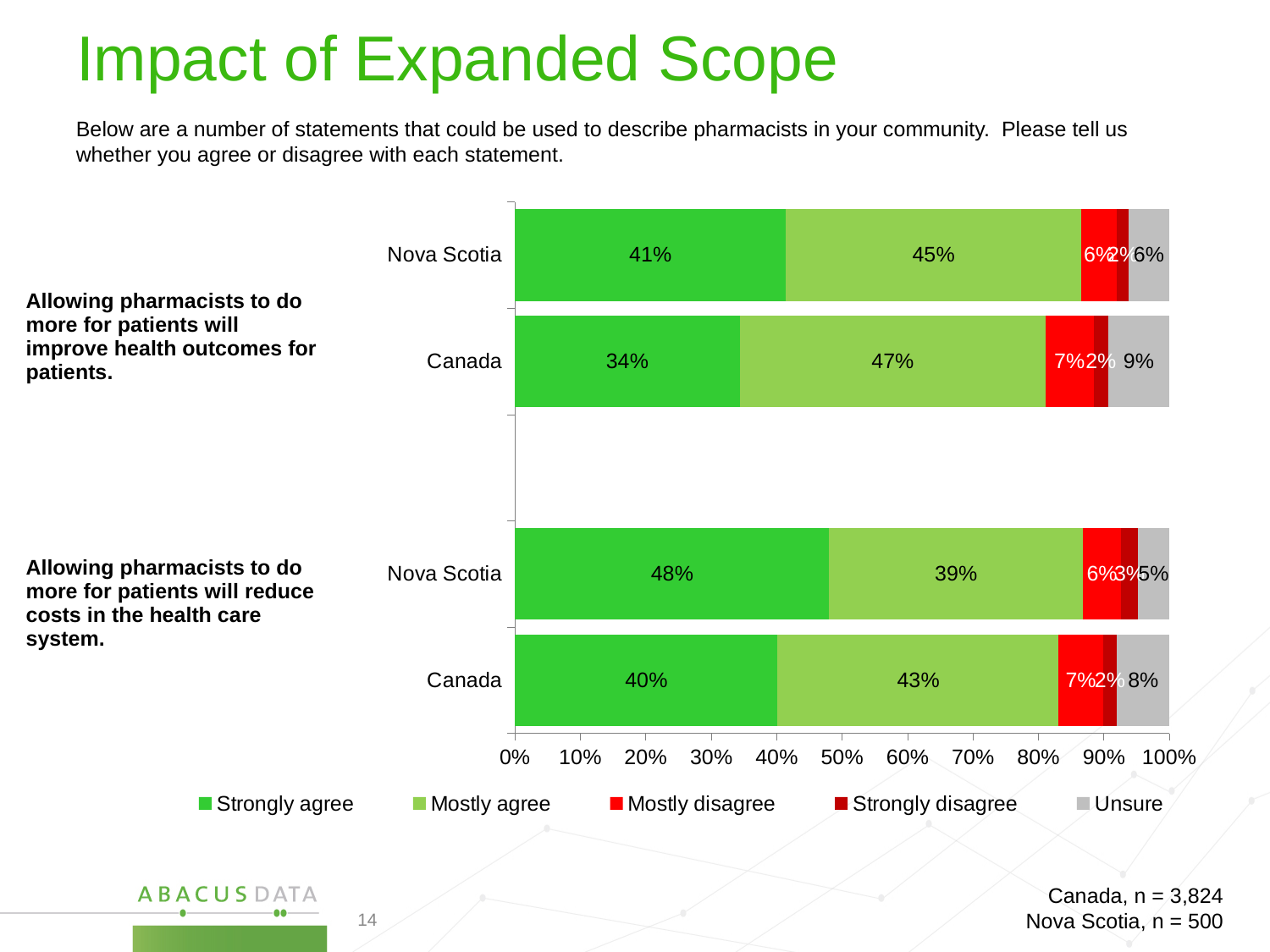
Which bar has the lowest 'Strongly agree' percentage? Canada, improve health outcomes for patients What percentage of Canada respondents mostly agree that allowing pharmacists to do more will improve health outcomes for patients? 47% How many bars are plotted in the chart? 4 What colour represents 'Unsure' in the legend? Grey For the statement about improving health outcomes, which has the larger 'Strongly agree' share: Nova Scotia or Canada? Nova Scotia What percentage of Canada respondents are unsure about the statement that allowing pharmacists to do more will reduce costs in the health care system? 8% What kind of chart is shown on the slide? Stacked bar chart What percentage of Nova Scotia respondents strongly agree that allowing pharmacists to do more will improve health outcomes for patients? 41% For the statement about reducing costs, what is the difference between the 'Strongly agree' percentages for Nova Scotia and Canada? 8% What percentage of Nova Scotia respondents strongly agree that allowing pharmacists to do more will reduce costs in the health care system? 48% Which bar has the highest 'Strongly agree' percentage? Nova Scotia, reduce costs in the health care system How many series does the legend list? 5